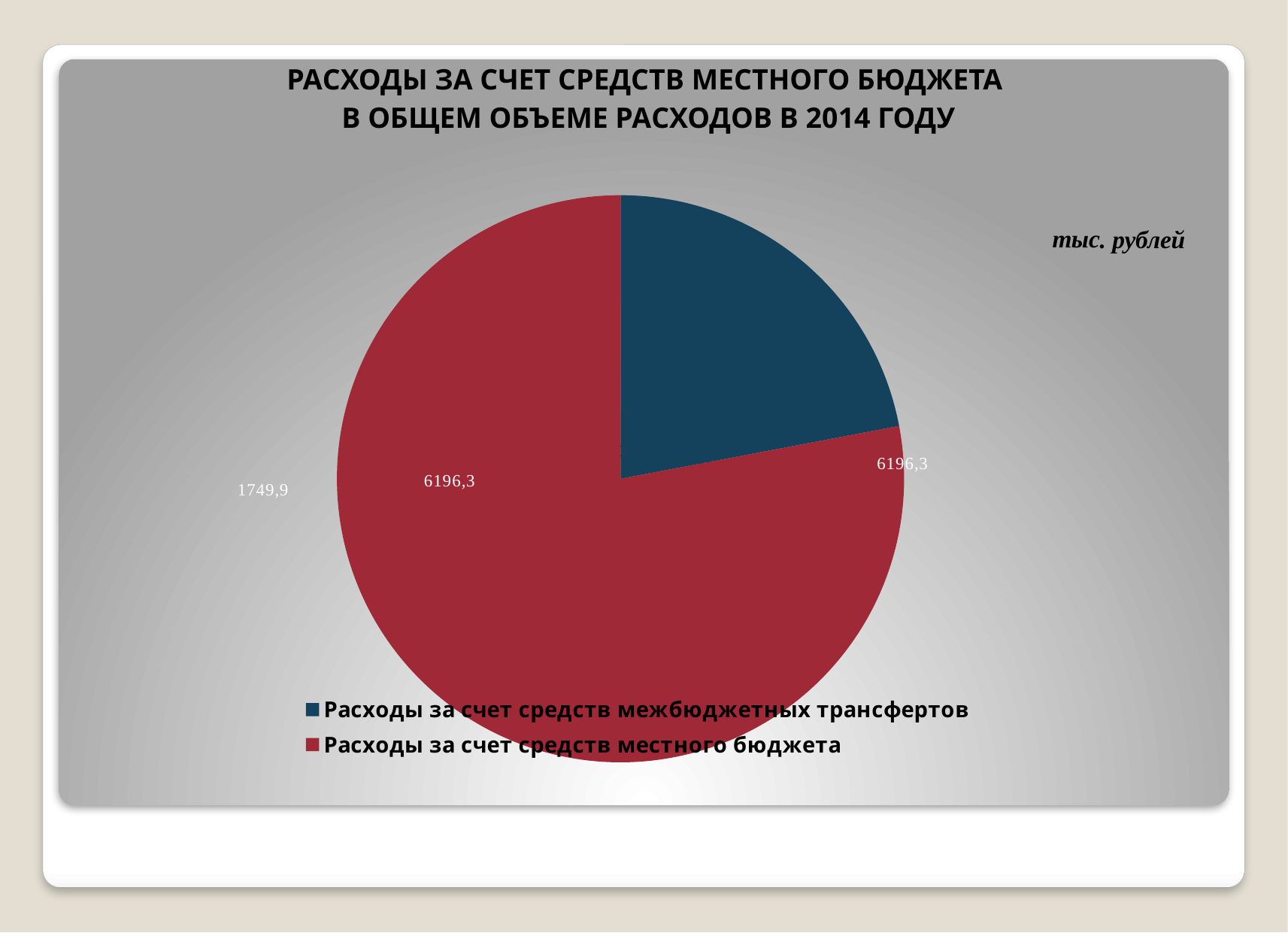
Which slice is larger: 'Расходы за счет средств межбюджетных трансфертов' or 'Расходы за счет средств местного бюджета'? Расходы за счет средств местного бюджета What value is printed to the left of the pie, outside the chart? 1749,9 Which category has the largest slice of the pie? Расходы за счет средств местного бюджета What unit is indicated on the slide for the chart values? тыс. рублей What is the title of the chart? РАСХОДЫ ЗА СЧЕТ СРЕДСТВ МЕСТНОГО БЮДЖЕТА В ОБЩЕМ ОБЪЕМЕ РАСХОДОВ В 2014 ГОДУ Which category has the smallest slice of the pie? Расходы за счет средств межбюджетных трансфертов Is the share of the pie for 'Расходы за счет средств межбюджетных трансфертов' greater or less than 50%? less What kind of chart is shown on the slide? pie chart How many slices does the pie chart have? 2 What value is printed inside the red slice of the pie? 6196,3 How many entries does the legend list? 2